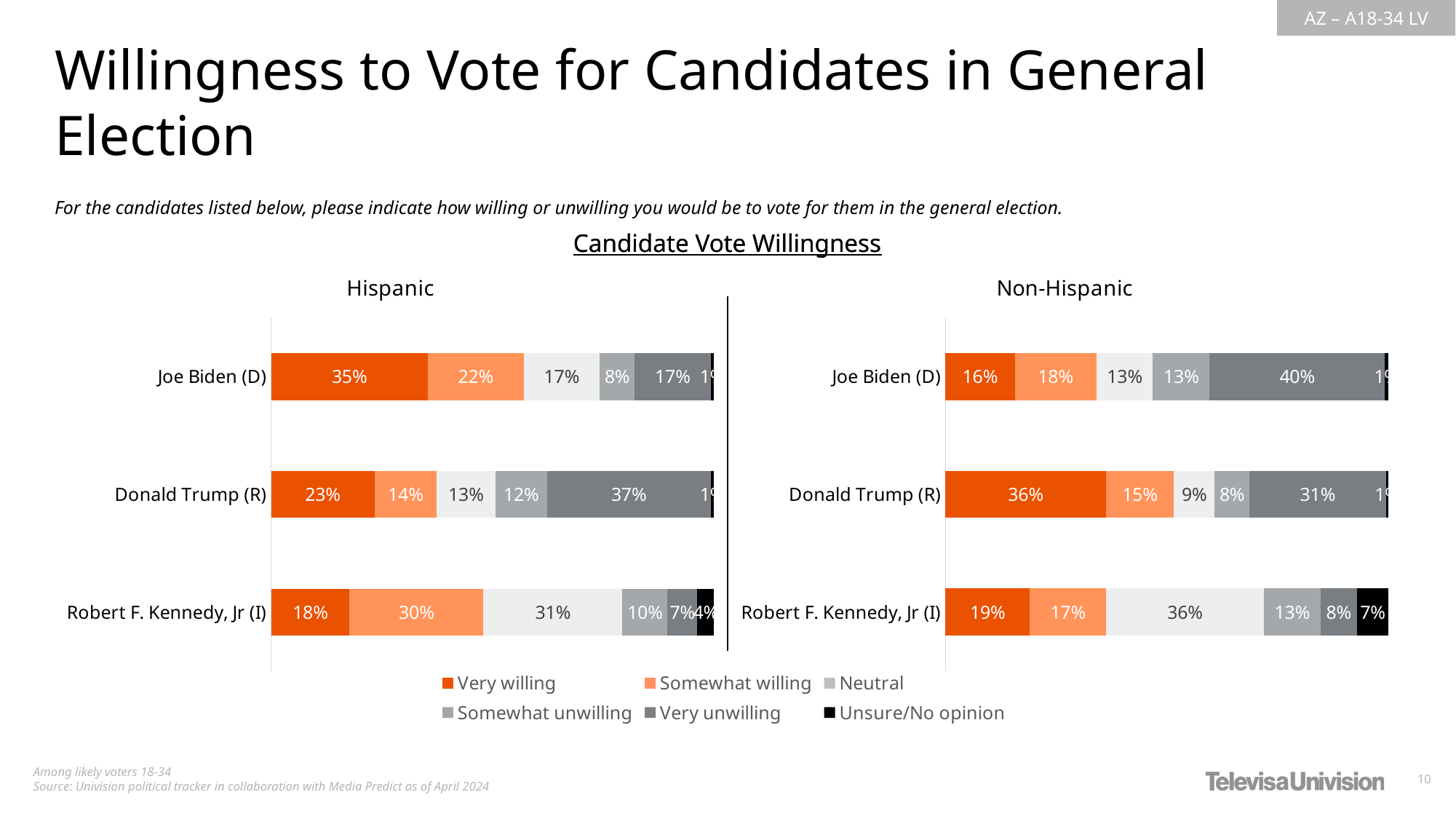
In the Hispanic chart, who has the larger Somewhat willing percentage, Joe Biden (D) or Robert F. Kennedy, Jr (I)? Robert F. Kennedy, Jr (I) In the Hispanic chart, what is the Neutral percentage for Robert F. Kennedy, Jr (I)? 31% In the Non-Hispanic chart, what is the Unsure/No opinion percentage for Robert F. Kennedy, Jr (I)? 7% In the Hispanic chart, which candidate has the highest Very willing percentage? Joe Biden (D) How many response categories does the legend list? 6 In the Non-Hispanic chart, which candidate has the lowest Very unwilling percentage? Robert F. Kennedy, Jr (I) In the Hispanic chart, what percentage of respondents are Very willing to vote for Joe Biden (D)? 35% How many candidates are shown in the Non-Hispanic chart? 3 In the Non-Hispanic chart, what percentage of respondents are Very unwilling to vote for Joe Biden (D)? 40% What type of chart is used for the Hispanic and Non-Hispanic panels? Stacked bar chart In the Non-Hispanic chart, what percentage of respondents are Very willing to vote for Donald Trump (R)? 36% In the Hispanic chart, how many percentage points higher is the Very unwilling share for Donald Trump (R) than for Joe Biden (D)? 20 percentage points